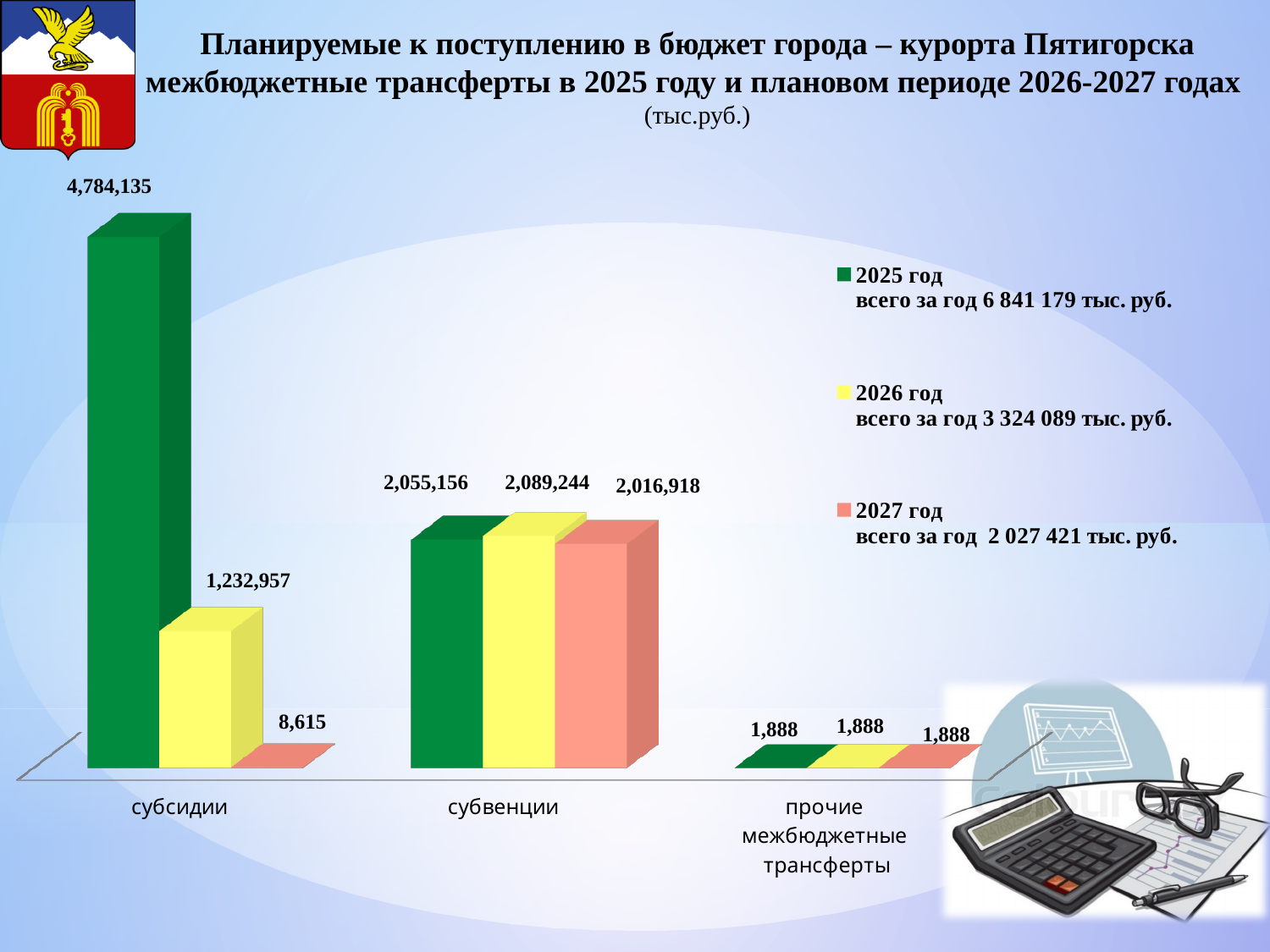
Which category has the highest value in the 2025 год series? субсидии How many categories are shown on the x axis? 3 Which category has the lowest value in the 2026 год series? прочие межбюджетные трансферты What is the value for субсидии in the 2027 год series? 8,615 What is the difference between the 2025 год and 2026 год values for субсидии? 3,551,178 Which is larger for субвенции: the 2026 год value or the 2027 год value? 2026 год How many series does the legend list? 3 According to the legend, what is the total for 2026 год? 3 324 089 тыс. руб. What kind of chart is shown on the slide? bar chart What is the value for прочие межбюджетные трансферты in the 2025 год series? 1,888 What is the value for субсидии in the 2025 год series? 4,784,135 What is the value for субвенции in the 2026 год series? 2,089,244